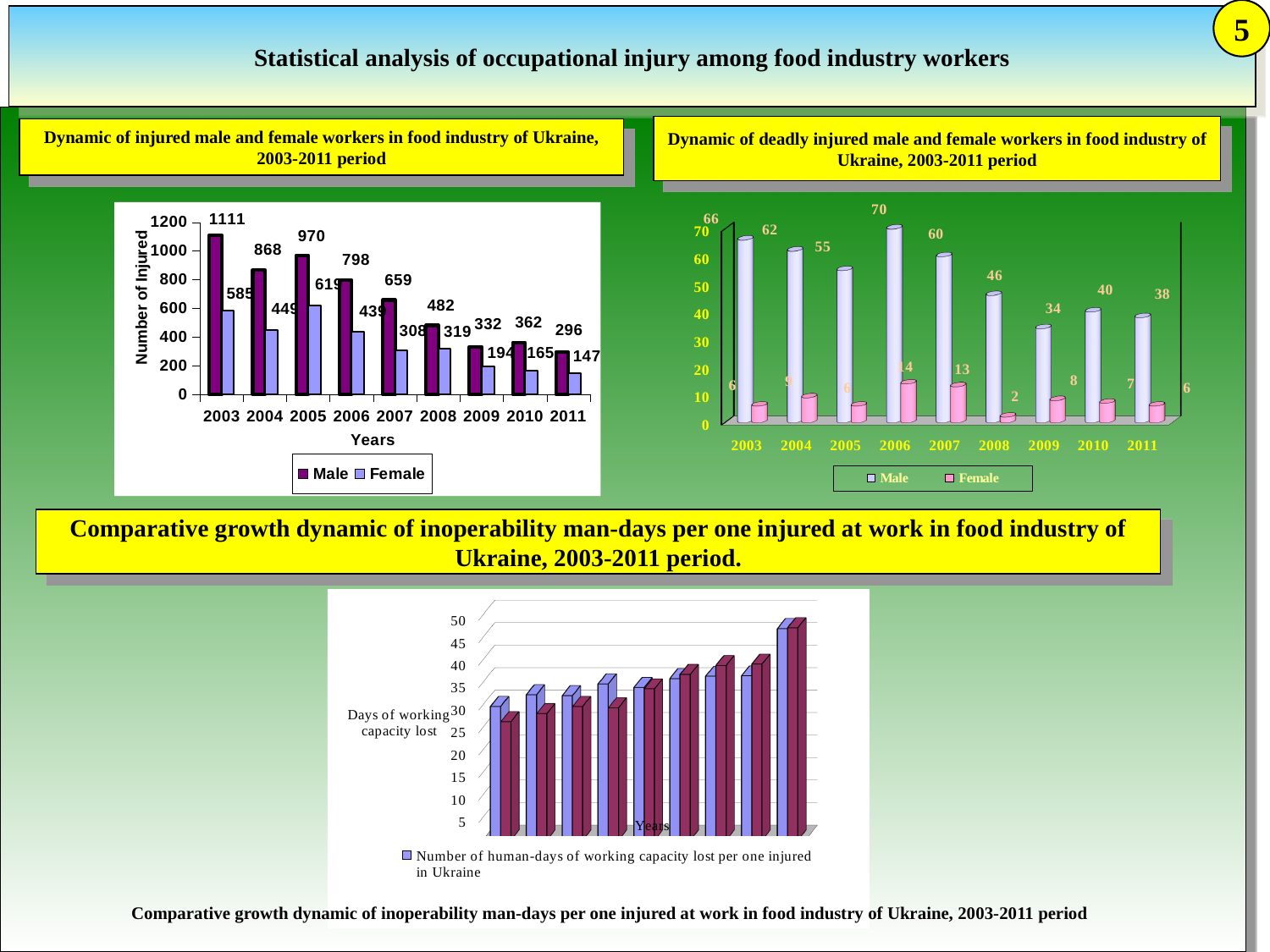
In the chart 'Dynamic of injured male and female workers in food industry of Ukraine, 2003-2011 period', which year has the highest number of injured male workers? 2003 In the chart 'Dynamic of injured male and female workers in food industry of Ukraine, 2003-2011 period', what is the number of injured male workers in 2003? 1111 What kind of chart is the bottom chart titled 'Comparative growth dynamic of inoperability man-days per one injured at work in food industry of Ukraine, 2003-2011 period'? bar chart In the chart 'Dynamic of deadly injured male and female workers in food industry of Ukraine, 2003-2011 period', how many series does the legend list? 2 In the chart 'Dynamic of injured male and female workers in food industry of Ukraine, 2003-2011 period', what is the number of injured female workers in 2011? 147 In the chart 'Dynamic of injured male and female workers in food industry of Ukraine, 2003-2011 period', how many years are shown on the x axis? 9 In the chart 'Dynamic of deadly injured male and female workers in food industry of Ukraine, 2003-2011 period', what is the number of deadly injured male workers in 2006? 70 In the chart 'Dynamic of deadly injured male and female workers in food industry of Ukraine, 2003-2011 period', which is larger: deadly injured male workers in 2010 or in 2011? 2010 In the chart 'Dynamic of injured male and female workers in food industry of Ukraine, 2003-2011 period', what is the difference between injured male and female workers in 2007? 351 In the bottom chart 'Comparative growth dynamic of inoperability man-days per one injured at work in food industry of Ukraine, 2003-2011 period', do the values generally rise or fall along the x axis? rise In the chart 'Dynamic of deadly injured male and female workers in food industry of Ukraine, 2003-2011 period', what is the number of deadly injured female workers in 2007? 13 In the chart 'Dynamic of deadly injured male and female workers in food industry of Ukraine, 2003-2011 period', which year has the lowest number of deadly injured female workers? 2008